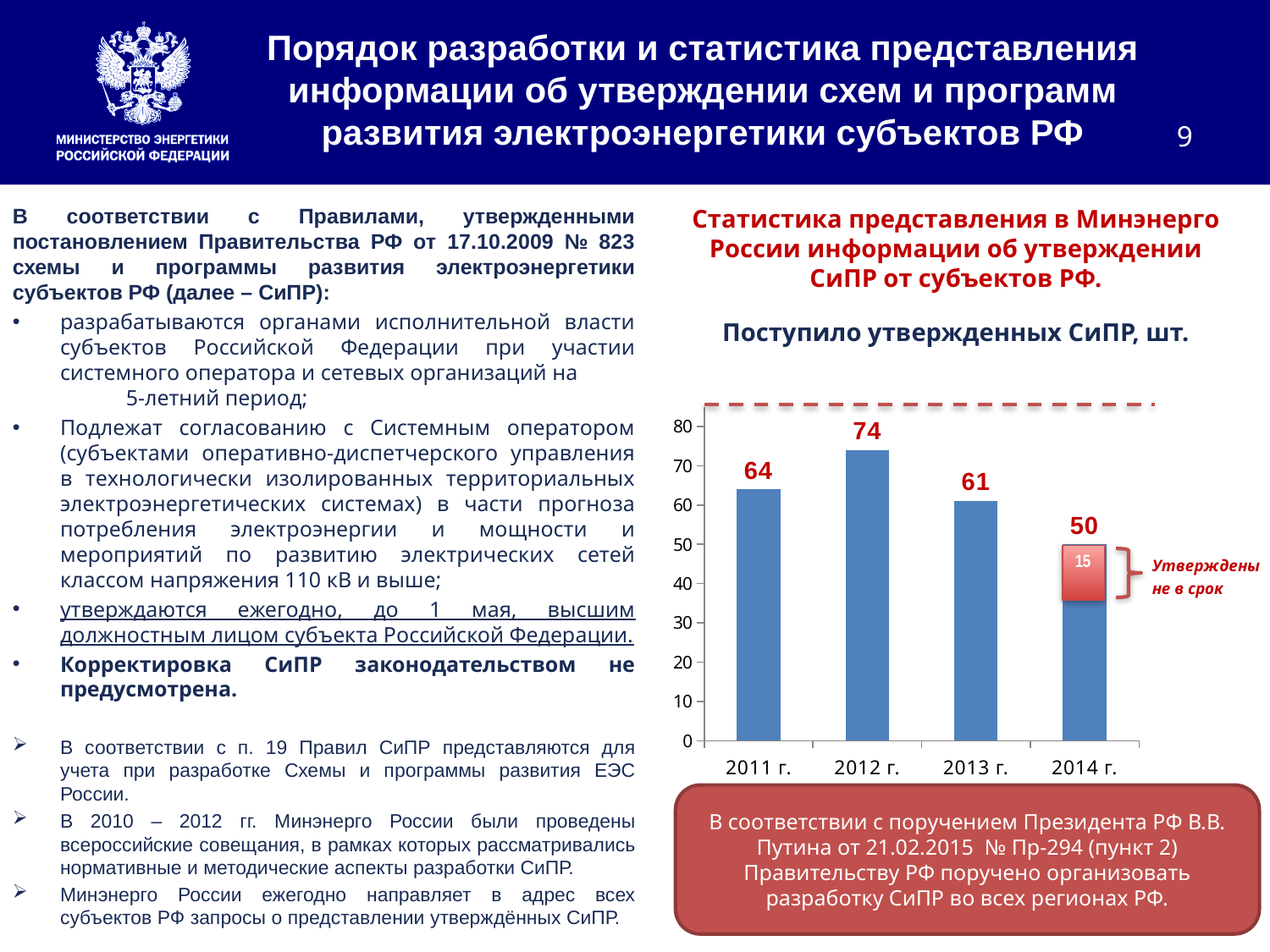
Which year has the highest value? 2012 г. Do the values rise or fall from 2012 г. to 2014 г.? fall What kind of chart is shown? bar chart What is the difference between the values for 2012 г. and 2014 г.? 24 Which year has the lowest value? 2014 г. What is the value for 2014 г.? 50 Which is larger, the value for 2011 г. or the value for 2013 г.? 2011 г. What is the value for 2011 г.? 64 What is the value for 2012 г.? 74 What is the value for 2013 г.? 61 How many years are shown on the x axis? 4 How many of the 2014 г. СиПР are marked as approved not on time (Утверждены не в срок)? 15